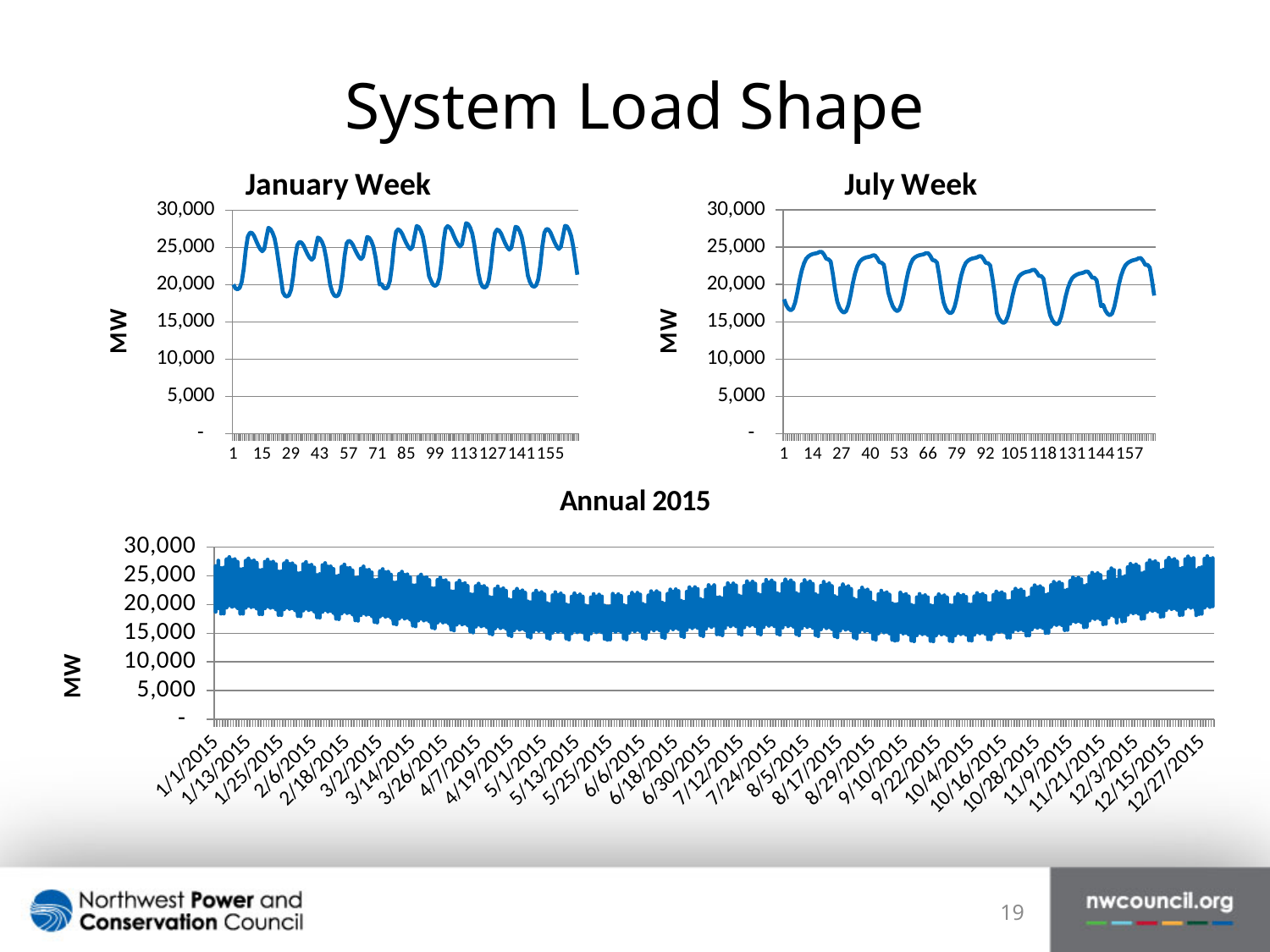
What is the y-axis label on the Annual 2015 chart? MW In the January Week chart, is the highest peak greater or less than 25,000? greater In the Annual 2015 chart, does the load generally rise or fall from October to December? rise What is the highest value shown on the y-axis of the July Week chart? 30,000 What kind of chart is the January Week chart? line chart In the July Week chart, is the highest peak greater or less than 25,000? less In the Annual 2015 chart, does the load generally rise or fall from January to May? fall In the Annual 2015 chart, are the values in July greater or less than 25,000? less Which chart shows a higher peak load, January Week or July Week? January Week How many charts are shown on the slide? 3